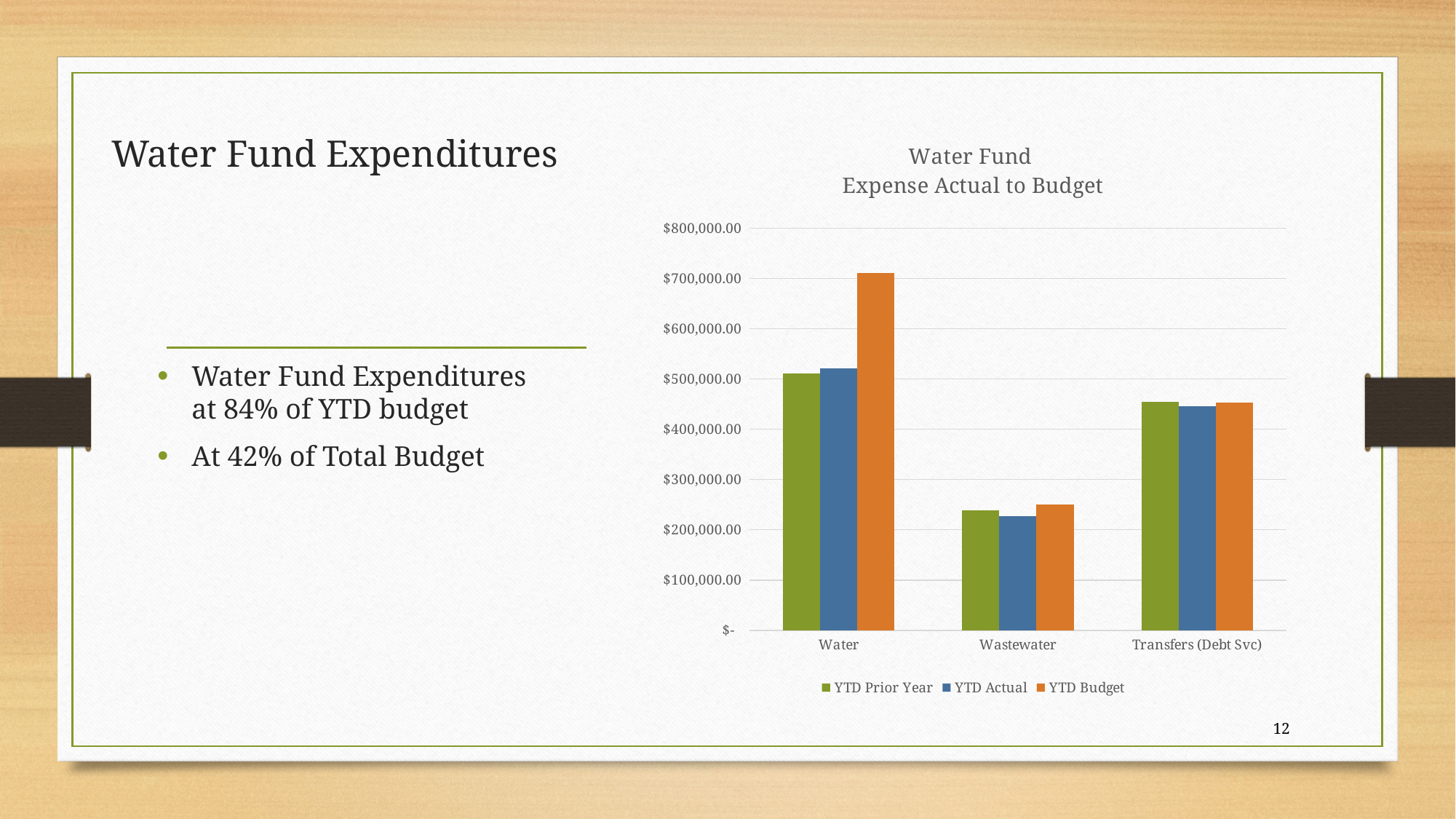
Is the YTD Budget value for Water greater or less than $600,000.00? greater Which category has the lowest YTD Actual value? Wastewater How many series does the chart's legend list? 3 What is the title of the chart? Water Fund Expense Actual to Budget For Wastewater, which is larger: YTD Budget or YTD Actual? YTD Budget How many categories are shown on the x axis of the chart? 3 What kind of chart is shown on the slide? bar chart Is the YTD Actual value for Wastewater greater or less than $300,000.00? less Is the YTD Prior Year value for Transfers (Debt Svc) greater or less than $500,000.00? less Which series is shown in orange in the chart? YTD Budget Which category has the highest YTD Budget value? Water For Water, which is larger: YTD Budget or YTD Actual? YTD Budget